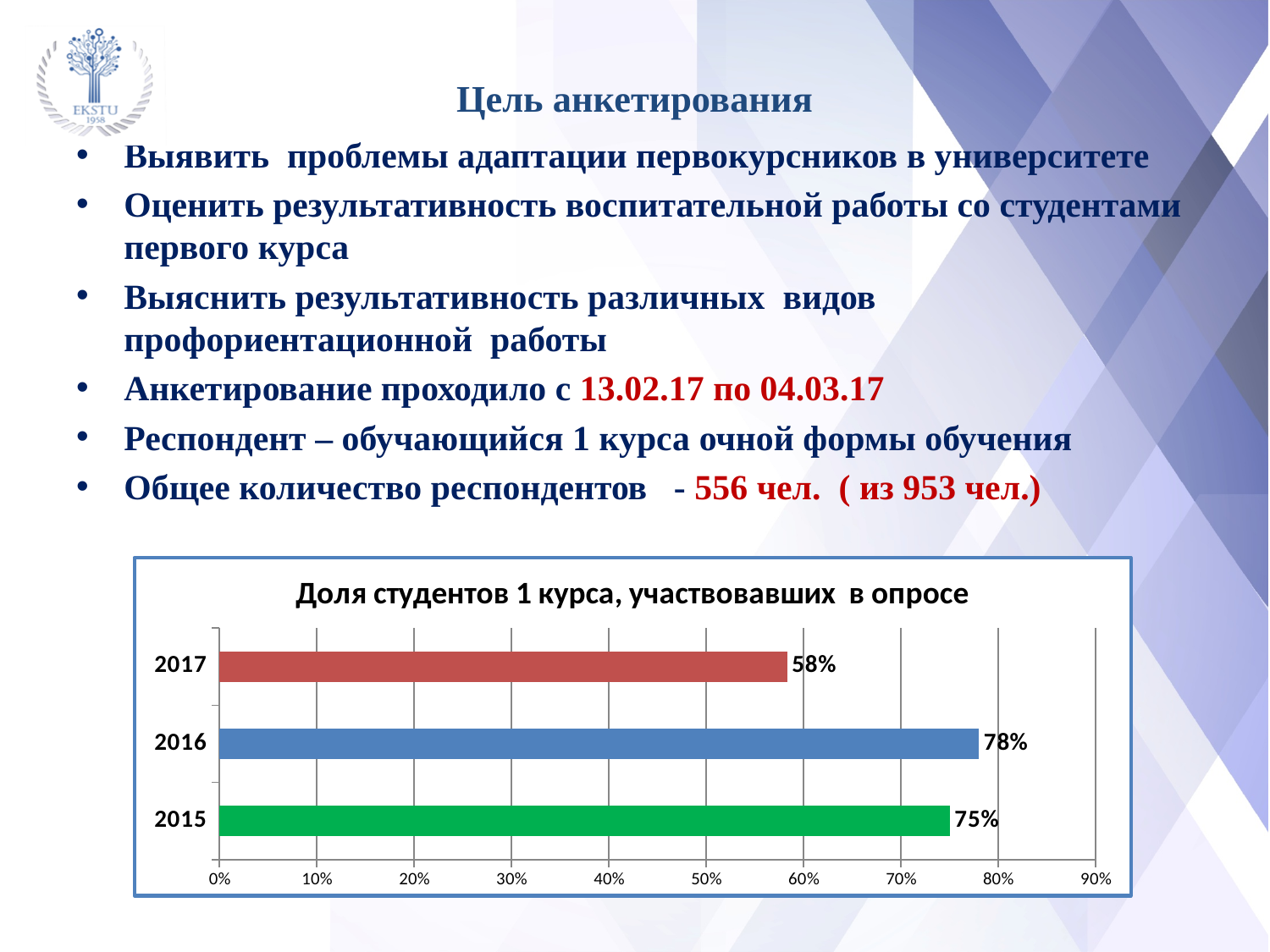
Is the value for 2017 greater or less than 60%? less What is the difference between the values for 2016 and 2015? 3% Which is larger, the value for 2015 or the value for 2017? 2015 What is the value for 2015 in the chart? 75% What is the value for 2017 in the chart? 58% What is the title of the chart? Доля студентов 1 курса, участвовавших в опросе Which year has the lowest value in the chart? 2017 What is the difference between the values for 2016 and 2017? 20% What kind of chart is shown on the slide? bar chart How many years are shown in the chart? 3 Which year has the highest value in the chart? 2016 What is the value for 2016 in the chart? 78%